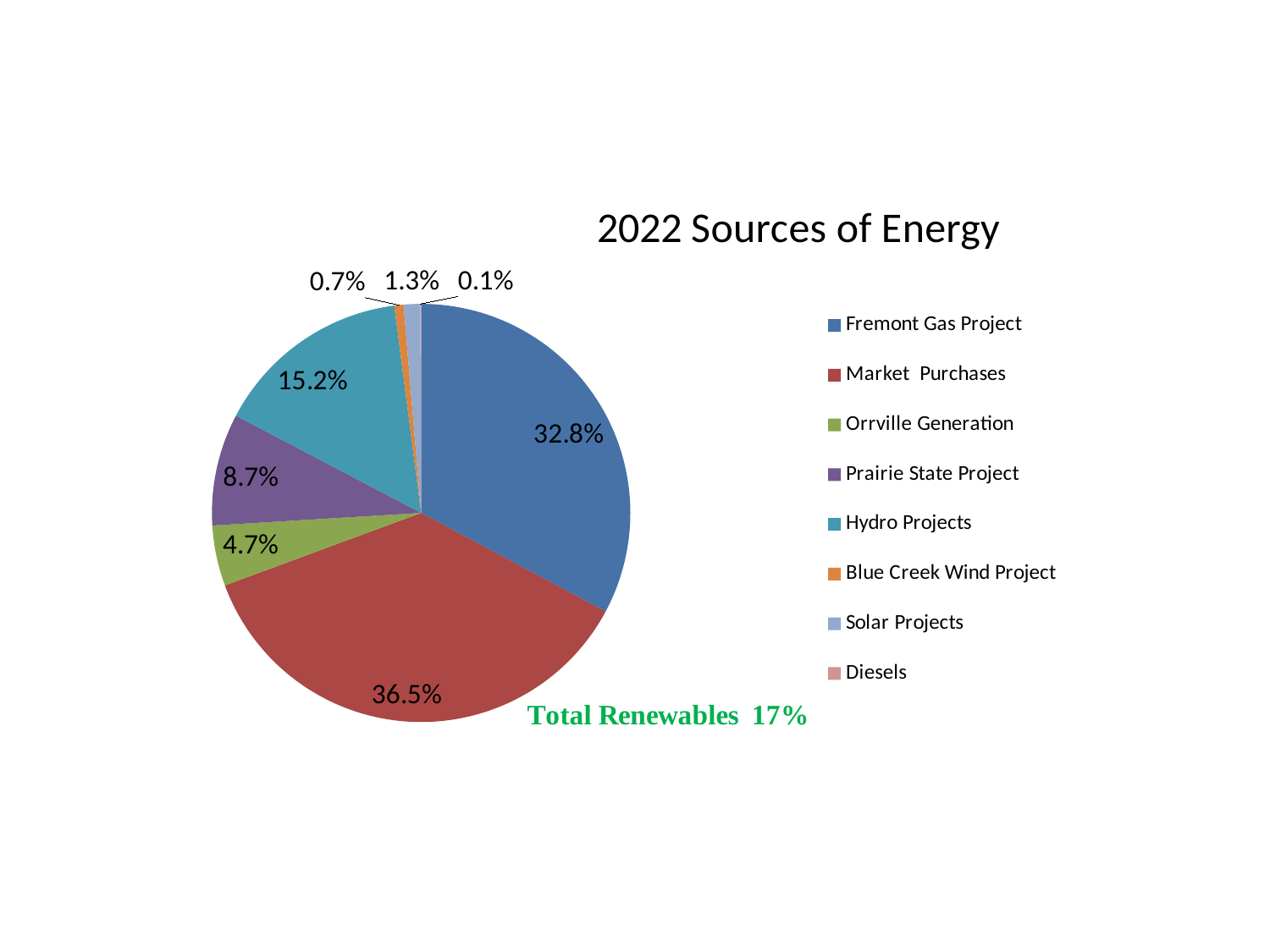
What share of the pie is the Prairie State Project? 8.7% Which is larger, the Hydro Projects share or the Prairie State Project share? Hydro Projects Which source has the largest slice of the pie? Market Purchases What kind of chart is shown on the slide? Pie chart What is the difference between the Market Purchases share and the Fremont Gas Project share? 3.7% What share of the pie is the Fremont Gas Project? 32.8% What share of the pie is Orrville Generation? 4.7% What is the title of the chart? 2022 Sources of Energy How many sources of energy are shown in the legend? 8 Which source has the smallest slice of the pie? Diesels